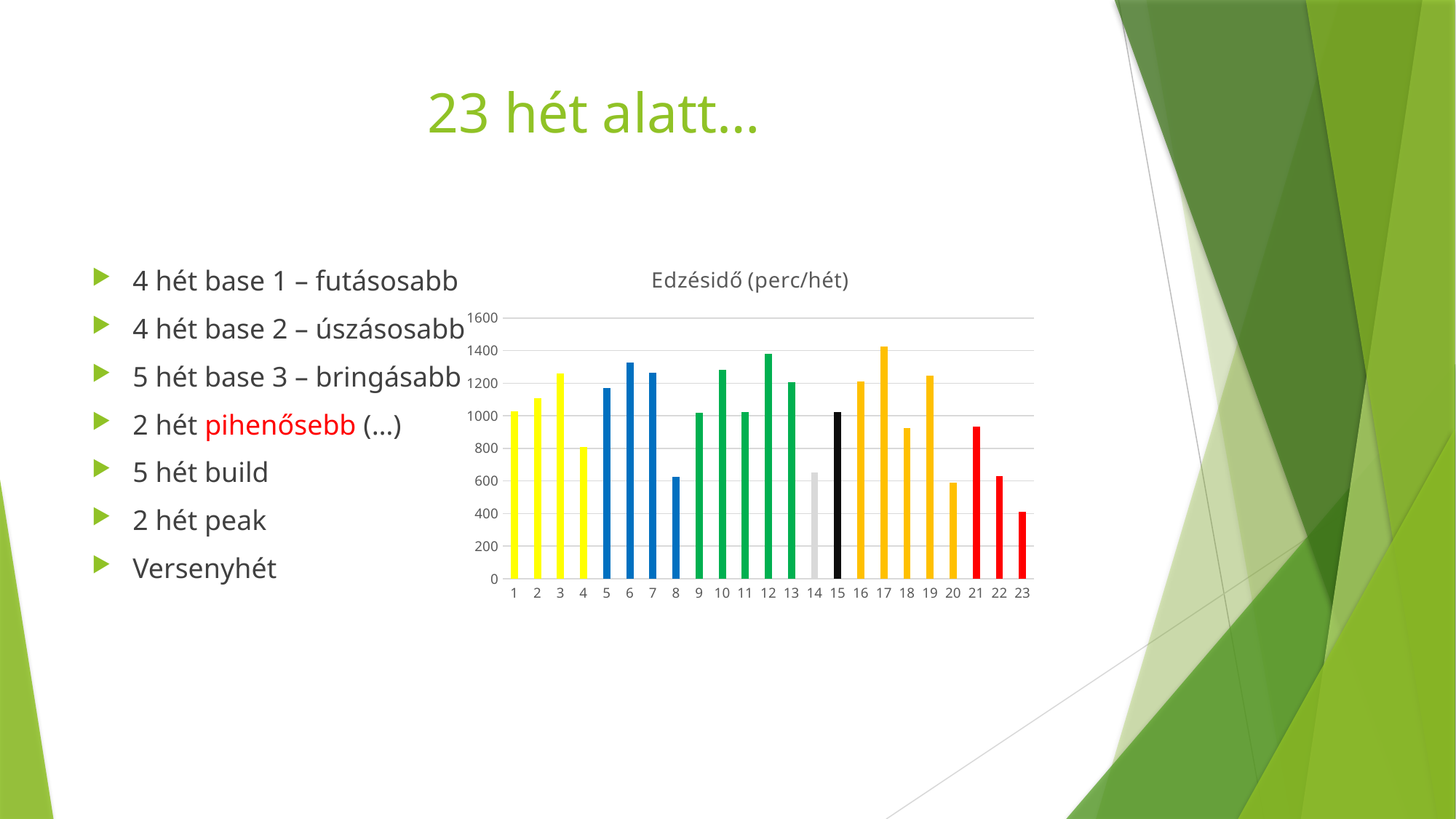
What is the title of the chart? Edzésidő (perc/hét) Which week has the highest training time in the chart? 17 Is the value for week 17 greater or less than 1200? greater Which week has the lowest training time in the chart? 23 Is the value for week 6 greater or less than 1200? greater Is the value for week 8 greater or less than 800? less What kind of chart is shown on the slide? bar chart How many weeks (categories) are plotted on the x axis of the chart? 23 Which week has the larger value, week 14 or week 15? 15 Which week has the larger value, week 3 or week 4? 3 Do the values rise or fall from week 21 to week 23? fall